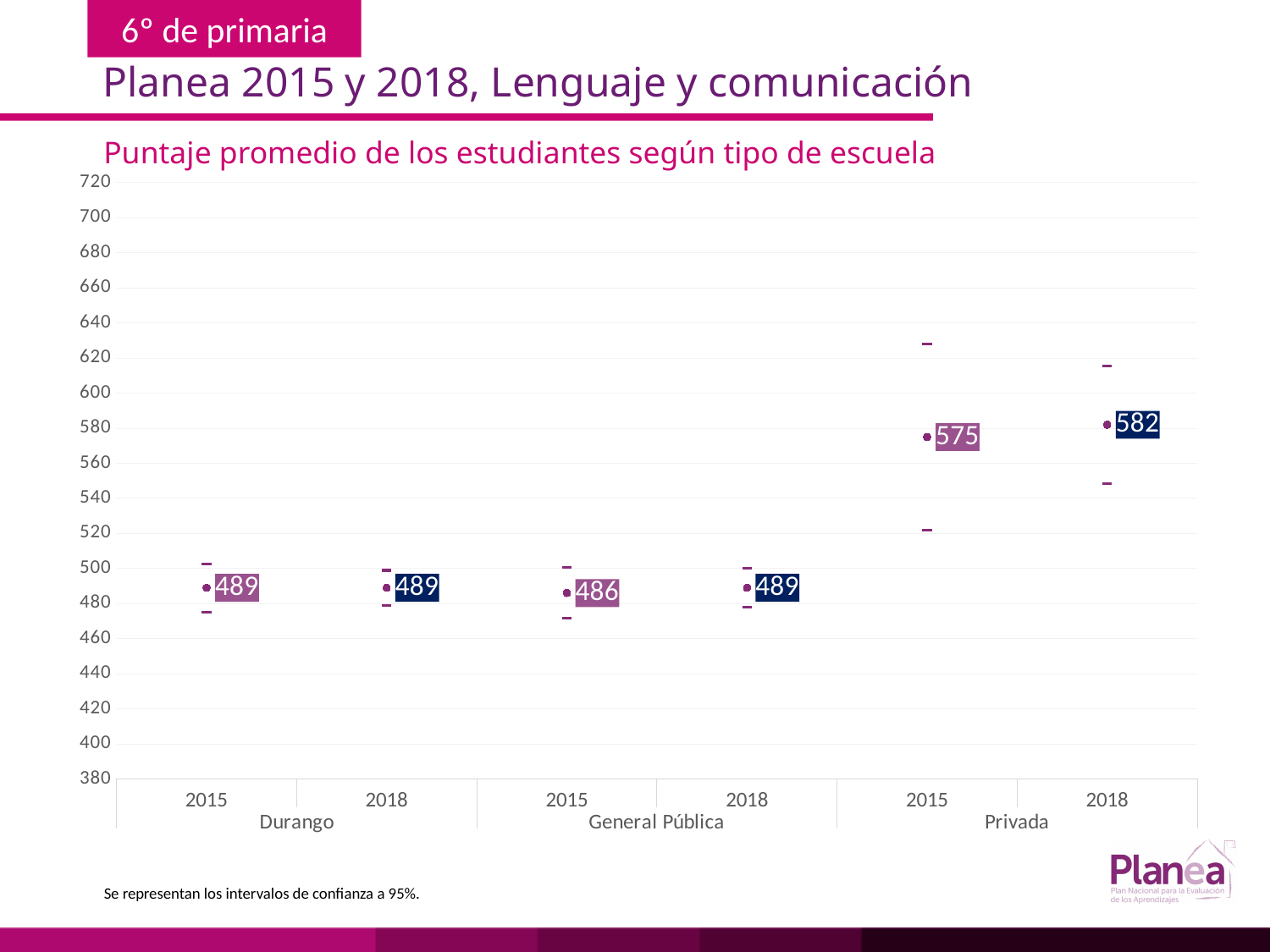
What is the difference between the Privada 2015 score and the Durango 2015 score? 86 What is the average score for Privada in 2018? 582 What is the difference between the Privada scores in 2018 and 2015? 7 What is the average score for Privada in 2015? 575 How many data points are plotted on the chart? 6 Which school type and year has the lowest average score? General Pública 2015 What is the title of the chart? Puntaje promedio de los estudiantes según tipo de escuela Which is larger, the General Pública score in 2018 or in 2015? 2018 What is the average score for Durango in 2015? 489 Which school type and year has the highest average score? Privada 2018 Is the Privada 2015 score greater or less than 560? greater What is the average score for General Pública in 2015? 486